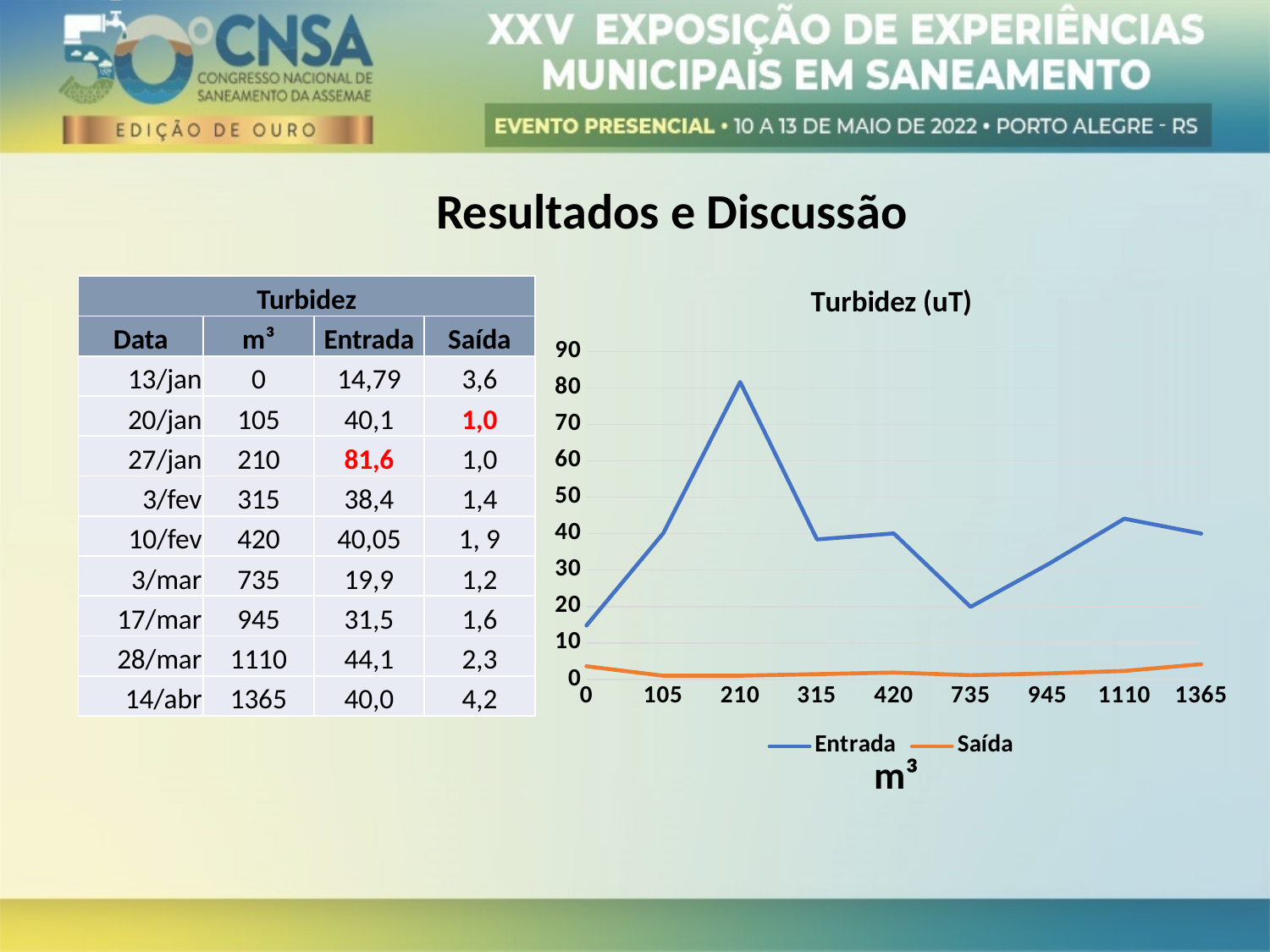
At which m³ value does the Entrada series reach its highest point? 210 How many points are plotted along the x axis of the chart? 9 What colour is the Saída line in the chart? orange What kind of chart is shown on the slide? line chart What is the title of the chart? Turbidez (uT) Is the Entrada value at 210 m³ greater or less than 80? greater What is the Entrada value at 210 m³? 81,6 Does the Entrada series rise or fall between 210 m³ and 315 m³? fall Is the Entrada value at 735 m³ greater or less than 30? less How many series does the chart legend list? 2 Which series is higher at 420 m³, Entrada or Saída? Entrada What is the Saída value at 1365 m³? 4,2